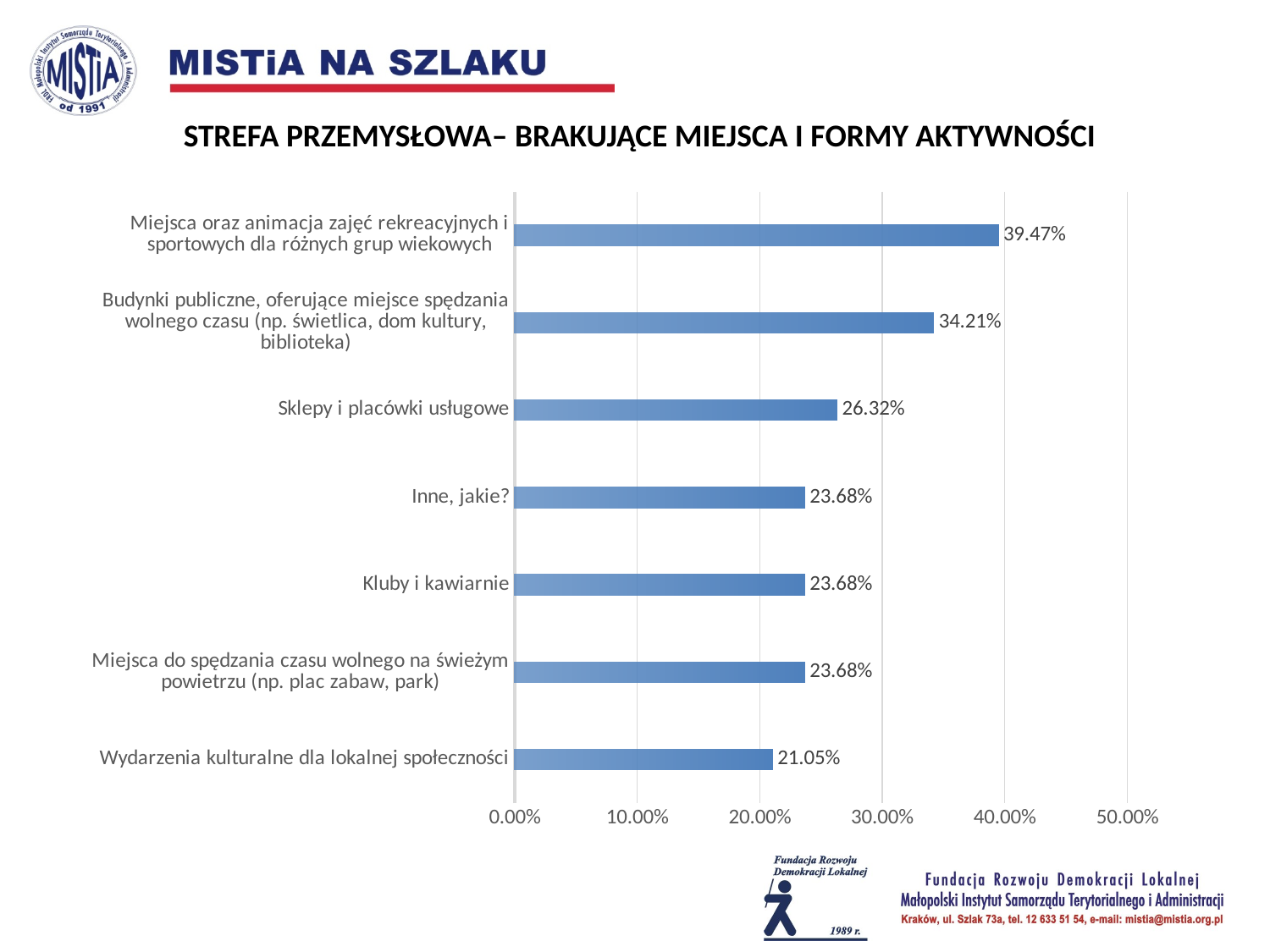
What is the title of the chart? STREFA PRZEMYSŁOWA– BRAKUJĄCE MIEJSCA I FORMY AKTYWNOŚCI What is the value for "Wydarzenia kulturalne dla lokalnej społeczności"? 21.05% What is the value for "Sklepy i placówki usługowe"? 26.32% What is the difference between the values for "Miejsca oraz animacja zajęć rekreacyjnych i sportowych dla różnych grup wiekowych" and "Budynki publiczne, oferujące miejsce spędzania wolnego czasu (np. świetlica, dom kultury, biblioteka)"? 5.26% Is the value for "Budynki publiczne, oferujące miejsce spędzania wolnego czasu (np. świetlica, dom kultury, biblioteka)" greater or less than 30.00%? greater What kind of chart is shown on the slide? bar chart What is the value for "Kluby i kawiarnie"? 23.68% Which category has the lowest value? Wydarzenia kulturalne dla lokalnej społeczności Which is larger: the value for "Sklepy i placówki usługowe" or the value for "Inne, jakie?"? Sklepy i placówki usługowe How many categories share the value 23.68%? 3 Which category has the highest value? Miejsca oraz animacja zajęć rekreacyjnych i sportowych dla różnych grup wiekowych How many categories are shown in the chart? 7